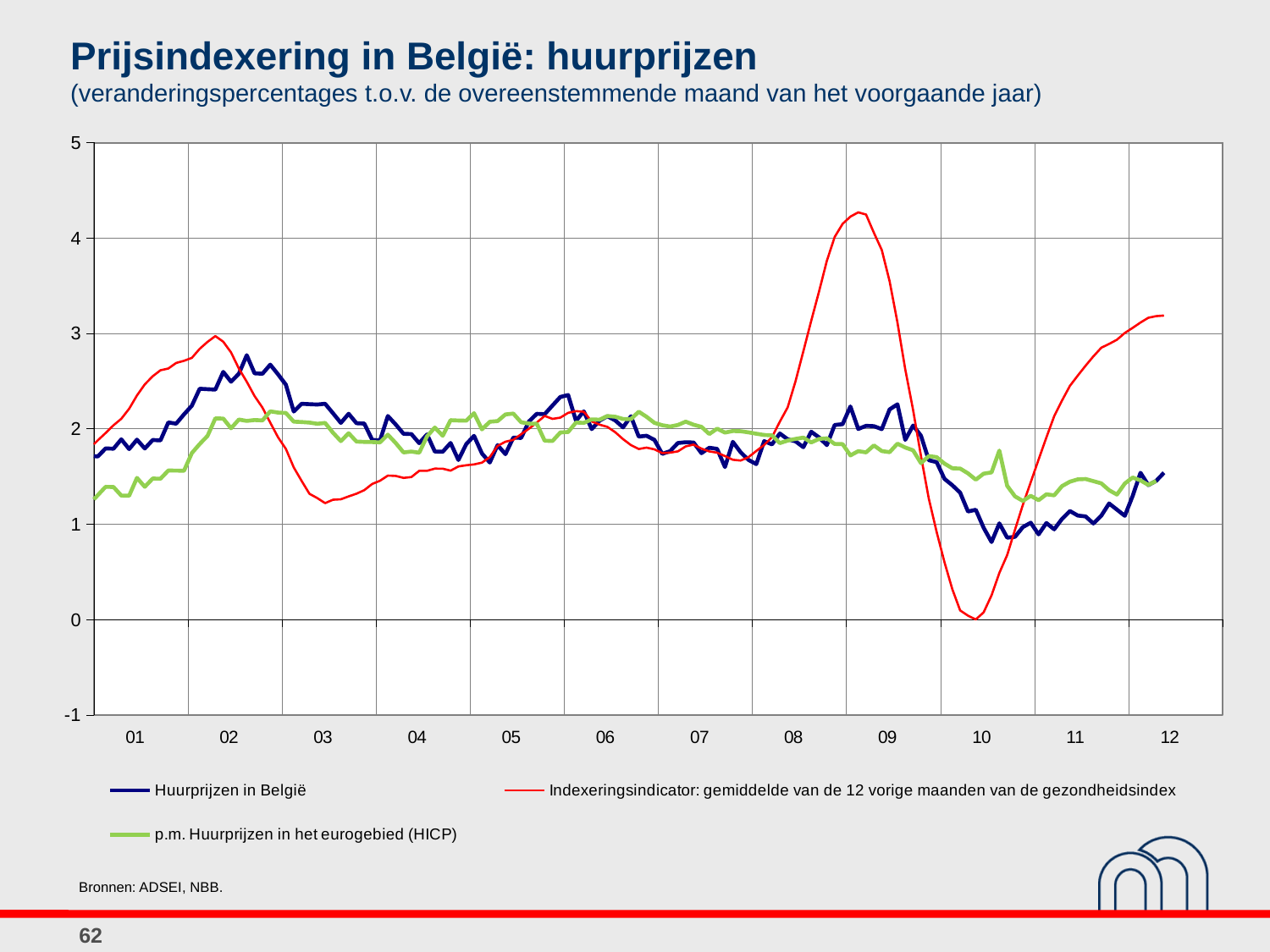
Is the value of the Huurprijzen in België series at the start of the chart (01) greater or less than 1? greater At the end of the chart (12), which series is higher: Indexeringsindicator or p.m. Huurprijzen in het eurogebied (HICP)? Indexeringsindicator How many series does the legend list? 3 Which series reaches the lowest value anywhere on the chart? Indexeringsindicator: gemiddelde van de 12 vorige maanden van de gezondheidsindex Is the lowest value of the Indexeringsindicator series around 2010 greater or less than 1? less How many year labels are shown along the x axis? 12 Is the peak value of the Indexeringsindicator series around 2008-2009 greater or less than 4? greater What is the title of the chart on the slide? Prijsindexering in België: huurprijzen Which series reaches the highest value anywhere on the chart? Indexeringsindicator: gemiddelde van de 12 vorige maanden van de gezondheidsindex What kind of chart is shown on the slide? line chart Does the Indexeringsindicator series rise or fall between 09 and 10? fall